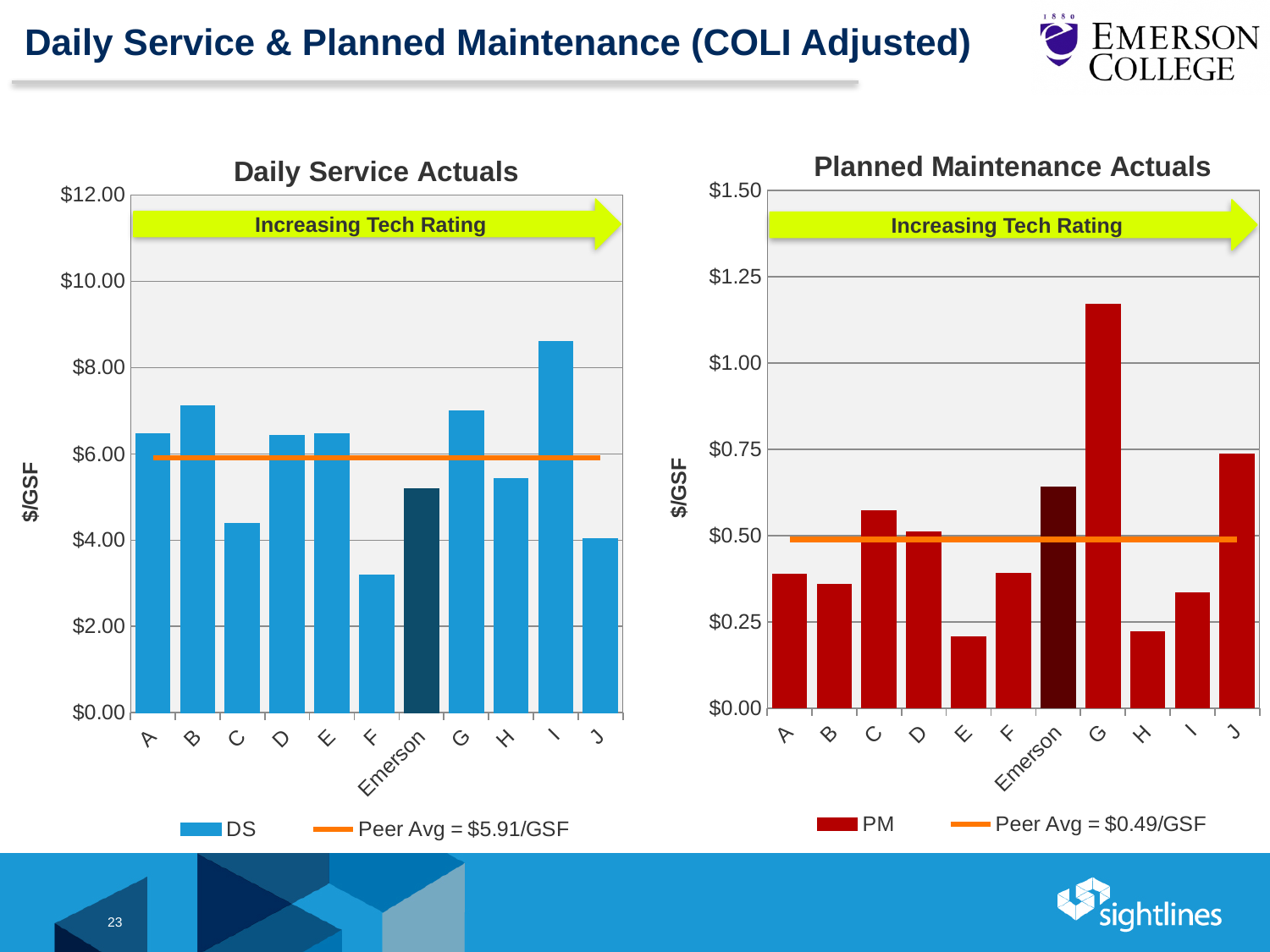
In the Daily Service Actuals chart, which category has the lowest value? F What kind of chart is the Daily Service Actuals chart? bar chart In the Daily Service Actuals chart, which is larger, the value for B or the value for C? B In the Daily Service Actuals chart, is the value for I greater or less than $8.00? greater In the Daily Service Actuals chart, which category has the highest value? I In the Planned Maintenance Actuals chart, which category has the lowest value? E In the Daily Service Actuals chart, is the value for Emerson greater or less than $6.00? less In the Planned Maintenance Actuals chart, which category has the highest value? G In the Planned Maintenance Actuals chart, is the value for Emerson greater or less than $0.50? greater In the Daily Service Actuals chart, what is the peer average shown in the legend? $5.91/GSF In the Planned Maintenance Actuals chart, what is the peer average shown in the legend? $0.49/GSF How many categories are shown on the x axis of the Planned Maintenance Actuals chart? 11